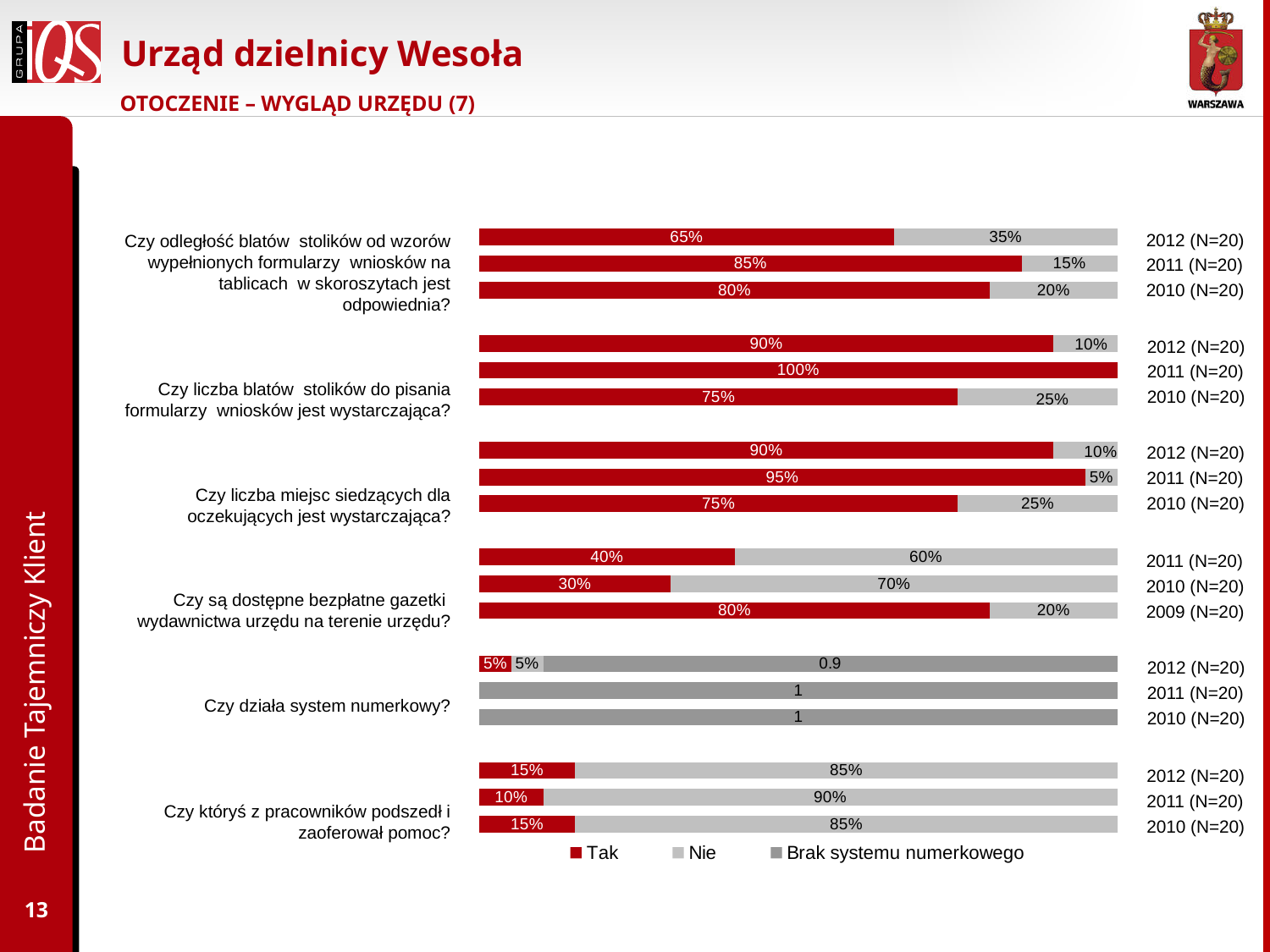
What kind of chart is shown on the slide? Stacked bar chart For the question "Czy są dostępne bezpłatne gazetki wydawnictwa urzędu na terenie urzędu?", which year has the larger "Tak" share, 2011 or 2010? 2011 How many series does the legend list? 3 What percentage answered "Nie" in 2010 for the question "Czy są dostępne bezpłatne gazetki wydawnictwa urzędu na terenie urzędu?"? 70% What percentage answered "Tak" in 2011 for the question "Czy liczba miejsc siedzących dla oczekujących jest wystarczająca?"? 95% What percentage answered "Tak" in 2012 for the question "Czy odległość blatów stolików od wzorów wypełnionych formularzy wniosków na tablicach w skoroszytach jest odpowiednia?"? 65% For the question "Czy liczba blatów stolików do pisania formularzy wniosków jest wystarczająca?", which year has the highest "Tak" share? 2011 What value is shown for "Brak systemu numerkowego" in 2012 for the question "Czy działa system numerkowy?"? 0.9 What are the entries listed in the chart legend? Tak, Nie, Brak systemu numerkowego What percentage answered "Nie" in 2010 for the question "Czy liczba blatów stolików do pisania formularzy wniosków jest wystarczająca?"? 25% What percentage answered "Tak" in 2011 for the question "Czy któryś z pracowników podszedł i zaoferował pomoc?"? 10% For the question "Czy odległość blatów stolików od wzorów wypełnionych formularzy wniosków na tablicach w skoroszytach jest odpowiednia?", what is the difference in the "Tak" share between 2011 and 2012? 20 percentage points